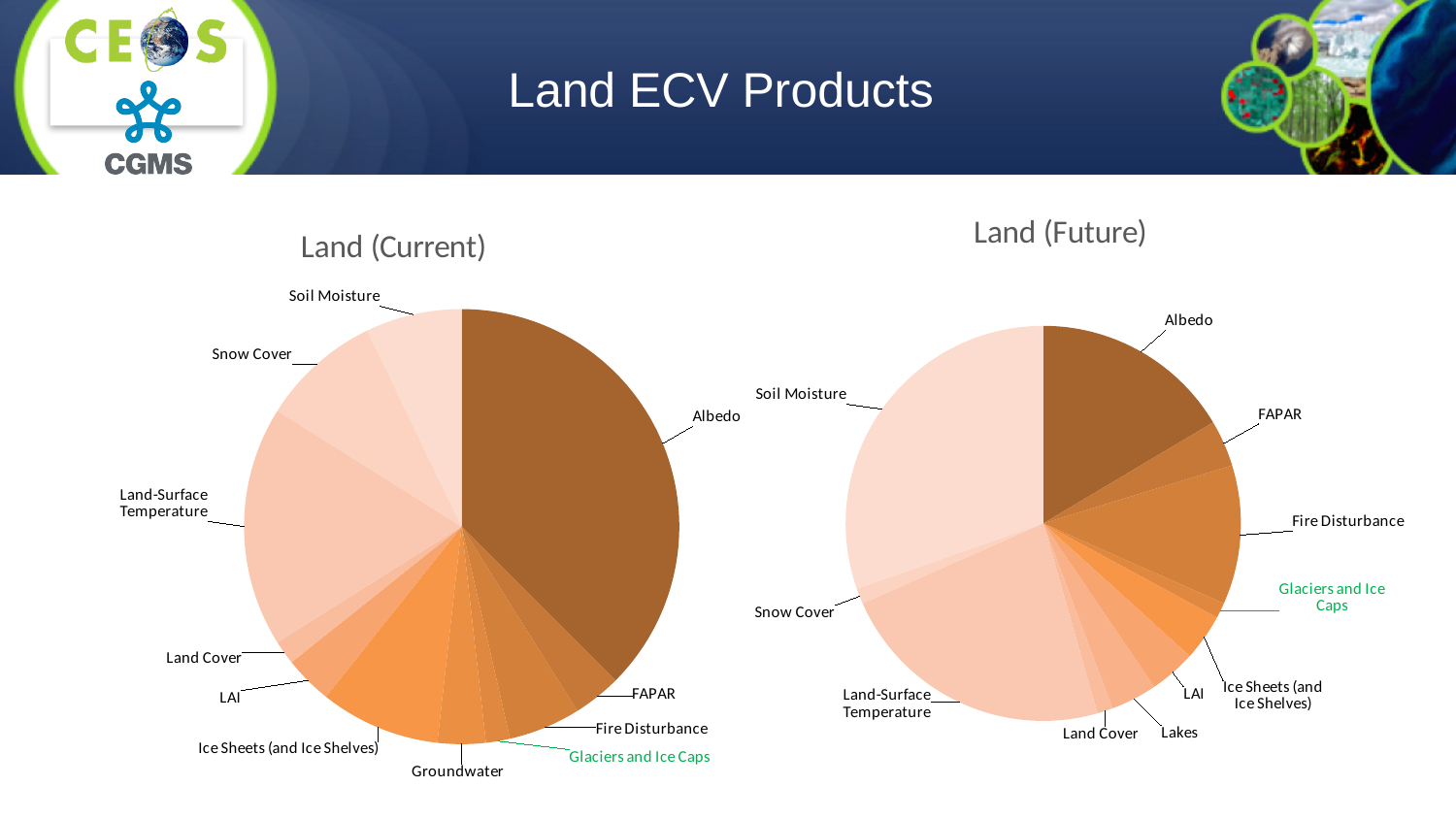
How many categories (slices) does the Land (Current) pie chart have? 11 In the Land (Current) chart, which slice is larger, Land-Surface Temperature or Snow Cover? Land-Surface Temperature In the Land (Current) chart, which slice is larger, Albedo or FAPAR? Albedo In the Land (Future) chart, which slice is larger, Soil Moisture or Albedo? Soil Moisture Which category appears in the Land (Current) chart but not in the Land (Future) chart? Groundwater What kind of chart is the Land (Current) chart? Pie chart Which category appears in the Land (Future) chart but not in the Land (Current) chart? Lakes In the Land (Future) chart, which category has the largest slice? Soil Moisture In the Land (Current) chart, which category has the largest slice? Albedo What kind of chart is the Land (Future) chart? Pie chart How many categories (slices) does the Land (Future) pie chart have? 11